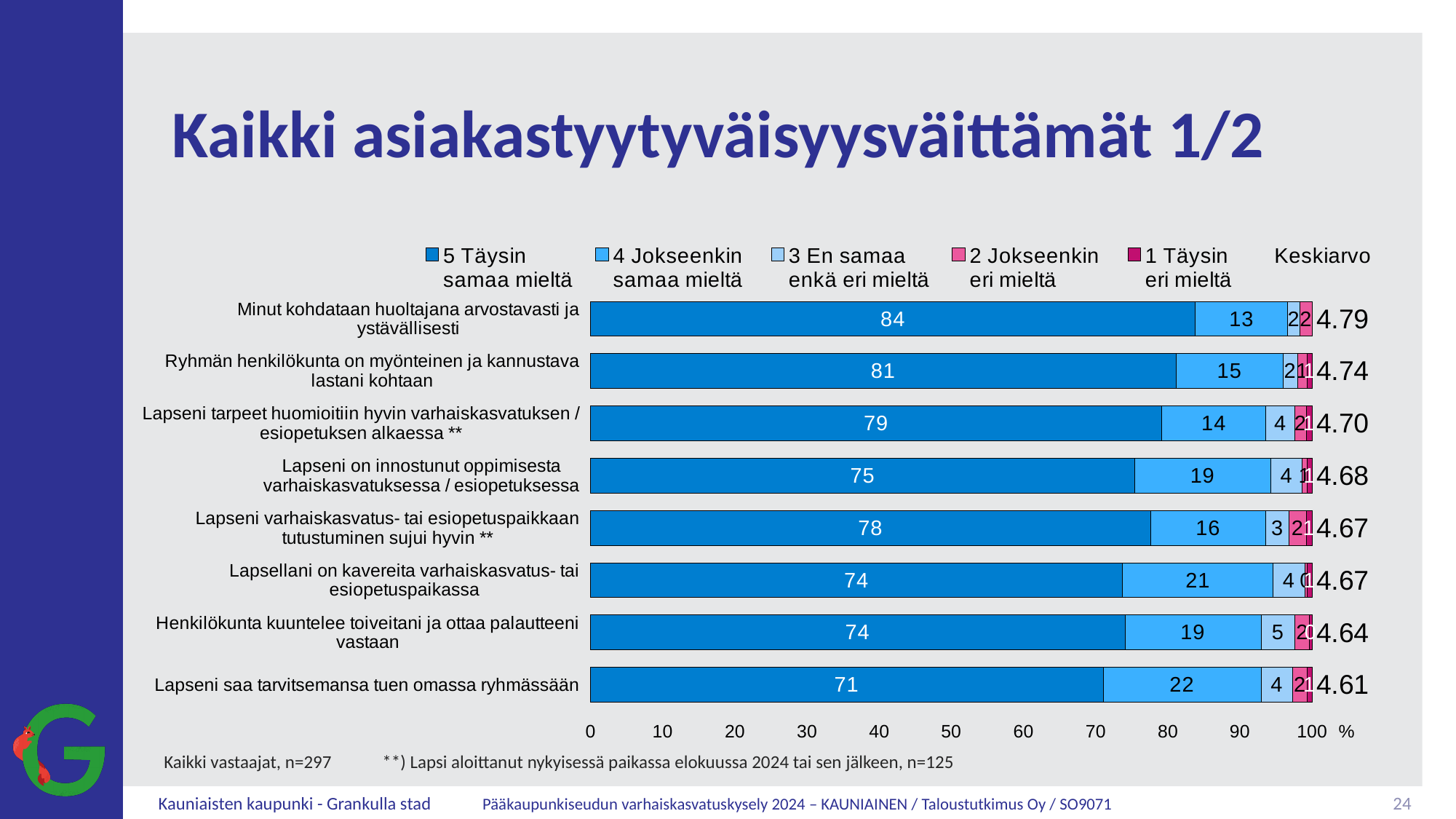
How many response categories (series) does the legend list, excluding Keskiarvo? 5 Which statement has the lowest share of '5 Täysin samaa mieltä' responses? Lapseni saa tarvitsemansa tuen omassa ryhmässään What is the Keskiarvo value for 'Lapseni tarpeet huomioitiin hyvin varhaiskasvatuksen / esiopetuksen alkaessa **'? 4.70 What percentage of respondents answered '5 Täysin samaa mieltä' for 'Minut kohdataan huoltajana arvostavasti ja ystävällisesti'? 84 What type of chart is shown on the slide? Stacked bar chart Which has a larger '5 Täysin samaa mieltä' share: 'Ryhmän henkilökunta on myönteinen ja kannustava lastani kohtaan' or 'Lapseni on innostunut oppimisesta varhaiskasvatuksessa / esiopetuksessa'? Ryhmän henkilökunta on myönteinen ja kannustava lastani kohtaan Is the '5 Täysin samaa mieltä' value for 'Henkilökunta kuuntelee toiveitani ja ottaa palautteeni vastaan' greater or less than 80? less Which statement has the highest Keskiarvo value? Minut kohdataan huoltajana arvostavasti ja ystävällisesti What percentage answered '4 Jokseenkin samaa mieltä' for 'Lapsellani on kavereita varhaiskasvatus- tai esiopetuspaikassa'? 21 What is the Keskiarvo (mean) shown for 'Lapseni saa tarvitsemansa tuen omassa ryhmässään'? 4.61 How many statements (bars) are shown in the chart? 8 What is the difference in the '5 Täysin samaa mieltä' percentage between 'Minut kohdataan huoltajana arvostavasti ja ystävällisesti' and 'Lapseni saa tarvitsemansa tuen omassa ryhmässään'? 13